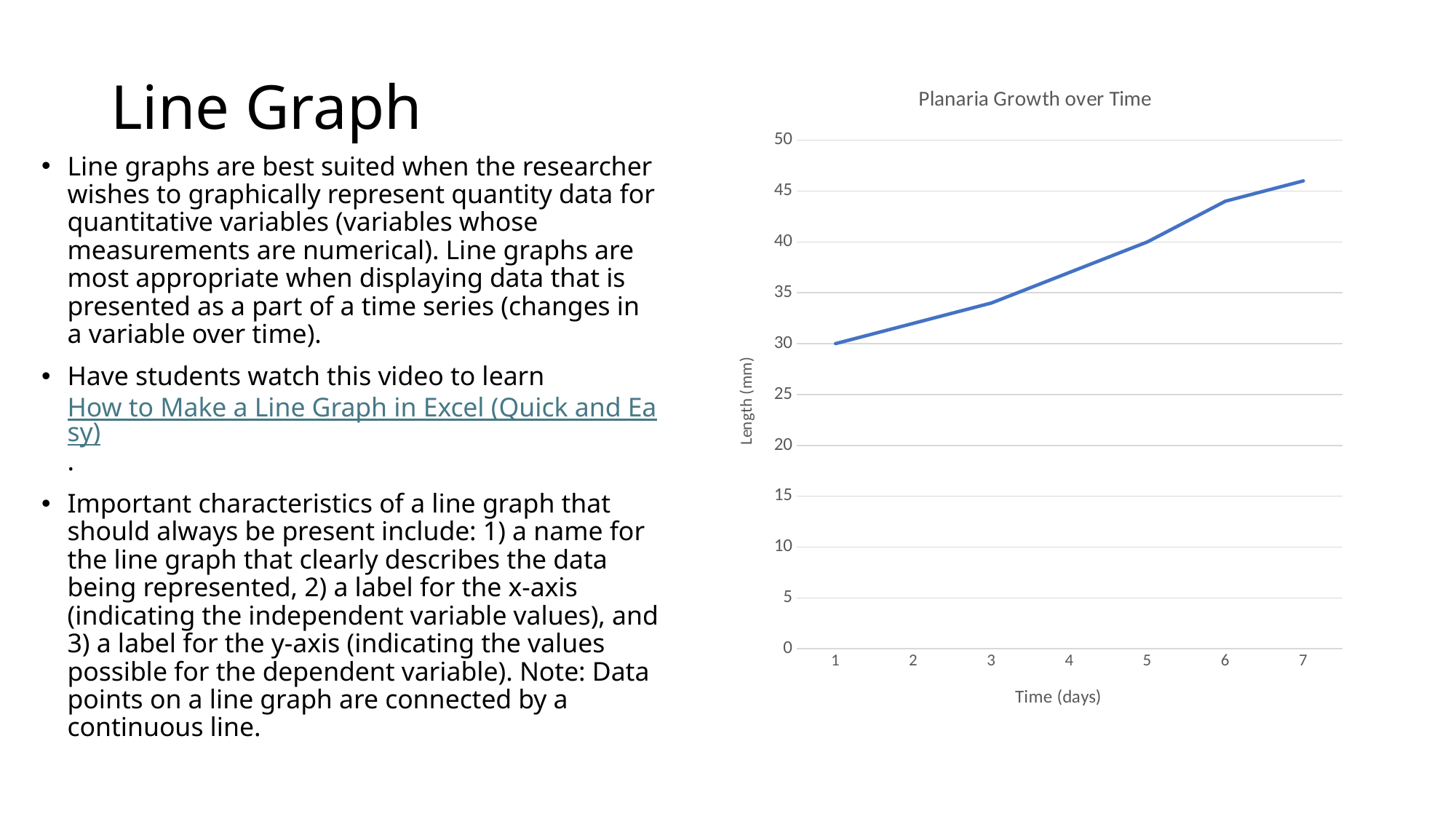
Do the values rise or fall as time increases along the x axis? rise How many data points are plotted on the line? 7 At which day is the length highest? 7 Is the value for day 3 greater or less than 35? less What is the title of the chart? Planaria Growth over Time Which is larger, the length at day 6 or the length at day 2? day 6 Is the value for day 6 greater or less than 40? greater At which day is the length lowest? 1 What is the label of the y axis of the chart? Length (mm) What is the length at day 1? 30 Is the value for day 7 greater or less than 45? greater What kind of chart is shown on the slide? line chart